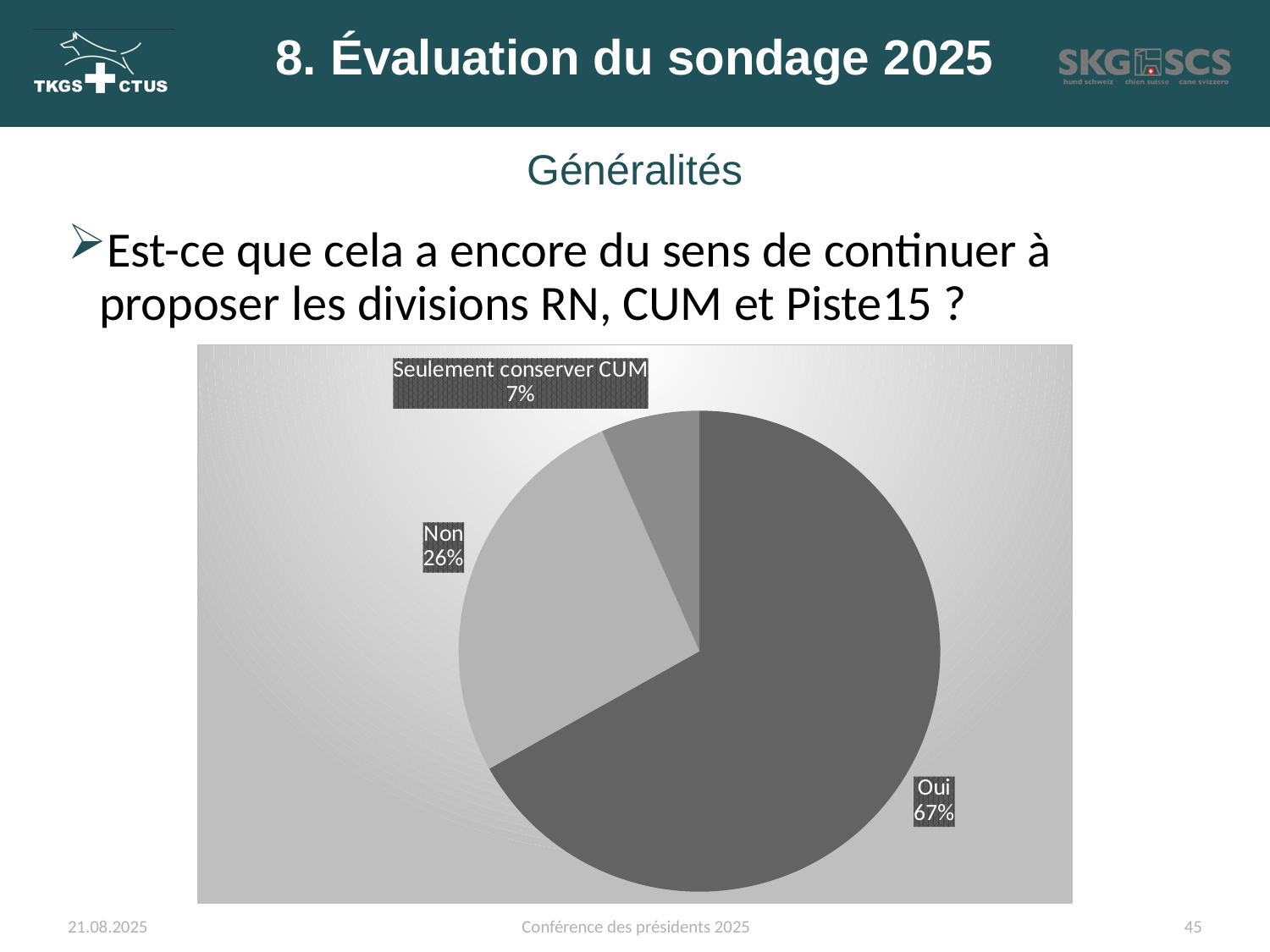
What percentage of responses are 'Non'? 26% Which is larger, the share for 'Non' or the share for 'Seulement conserver CUM'? Non What question does the pie chart answer, according to the slide? Est-ce que cela a encore du sens de continuer à proposer les divisions RN, CUM et Piste15 ? What is the difference in percentage points between 'Oui' and 'Non'? 41 What kind of chart is shown on the slide? pie chart Which response has the smallest share of the pie? Seulement conserver CUM Which response has the largest share of the pie? Oui How many slices does the pie chart have? 3 What is the difference in percentage points between 'Non' and 'Seulement conserver CUM'? 19 Is the share for 'Oui' greater or less than 50%? greater What percentage of responses are 'Seulement conserver CUM'? 7% What percentage of responses are 'Oui'? 67%